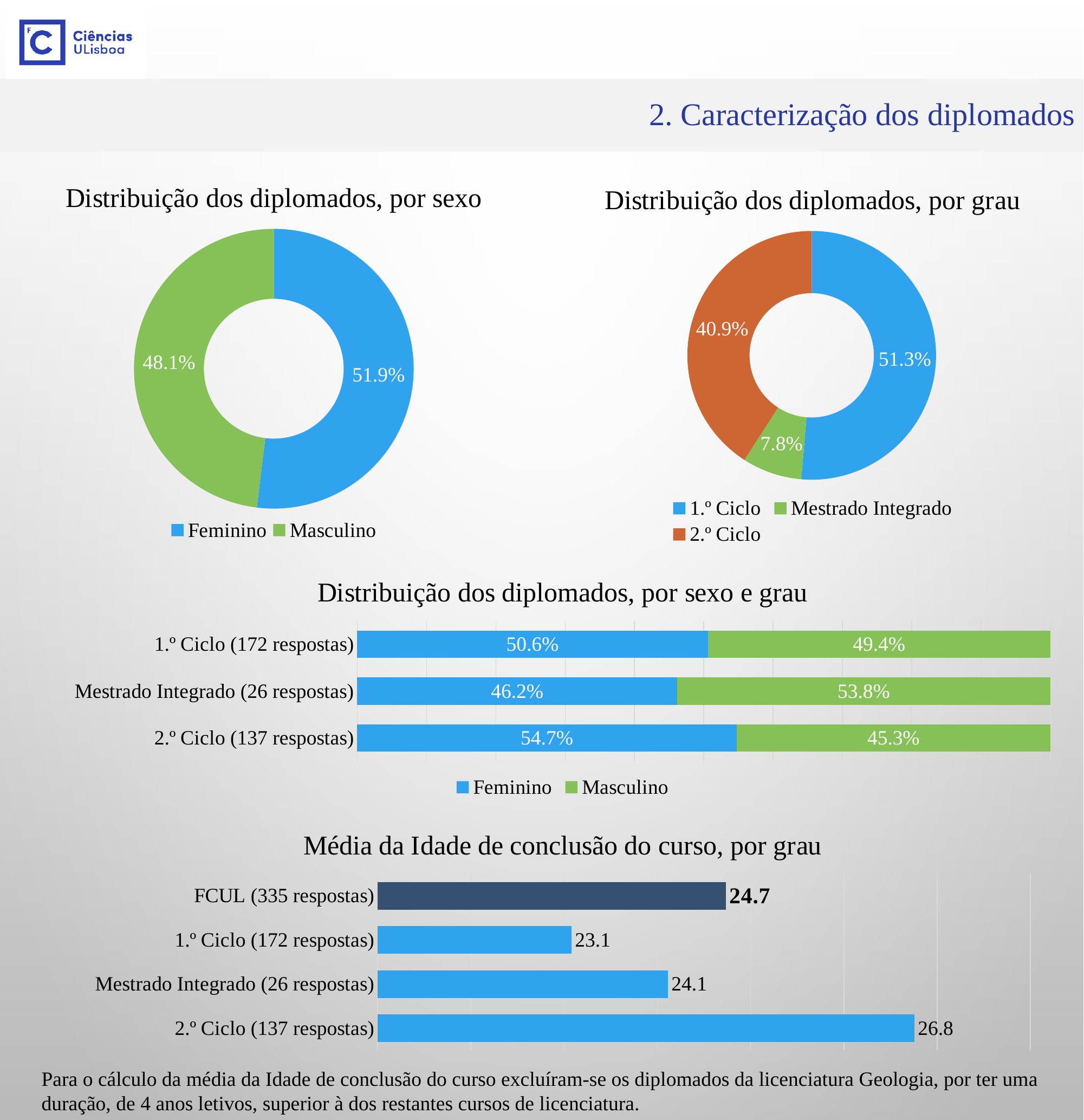
In the chart 'Distribuição dos diplomados, por sexo e grau', what is the Masculino value for Mestrado Integrado (26 respostas)? 53.8% What kind of chart is 'Média da Idade de conclusão do curso, por grau'? bar chart In the chart 'Distribuição dos diplomados, por grau', what share of graduates is 2.º Ciclo? 40.9% In the chart 'Média da Idade de conclusão do curso, por grau', what is the difference between 2.º Ciclo (137 respostas) and 1.º Ciclo (172 respostas)? 3.7 In the chart 'Distribuição dos diplomados, por grau', which degree has the largest share? 1.º Ciclo In the chart 'Distribuição dos diplomados, por grau', how many categories does the legend list? 3 In the chart 'Distribuição dos diplomados, por sexo e grau', what is the Feminino value for 2.º Ciclo (137 respostas)? 54.7% In the chart 'Distribuição dos diplomados, por sexo', what share of graduates is Masculino? 48.1% In the chart 'Distribuição dos diplomados, por grau', which degree has the smallest share? Mestrado Integrado In the chart 'Distribuição dos diplomados, por sexo', what share of graduates is Feminino? 51.9% In the chart 'Distribuição dos diplomados, por sexo e grau', how many series does the legend list? 2 In the chart 'Média da Idade de conclusão do curso, por grau', what is the value for 2.º Ciclo (137 respostas)? 26.8